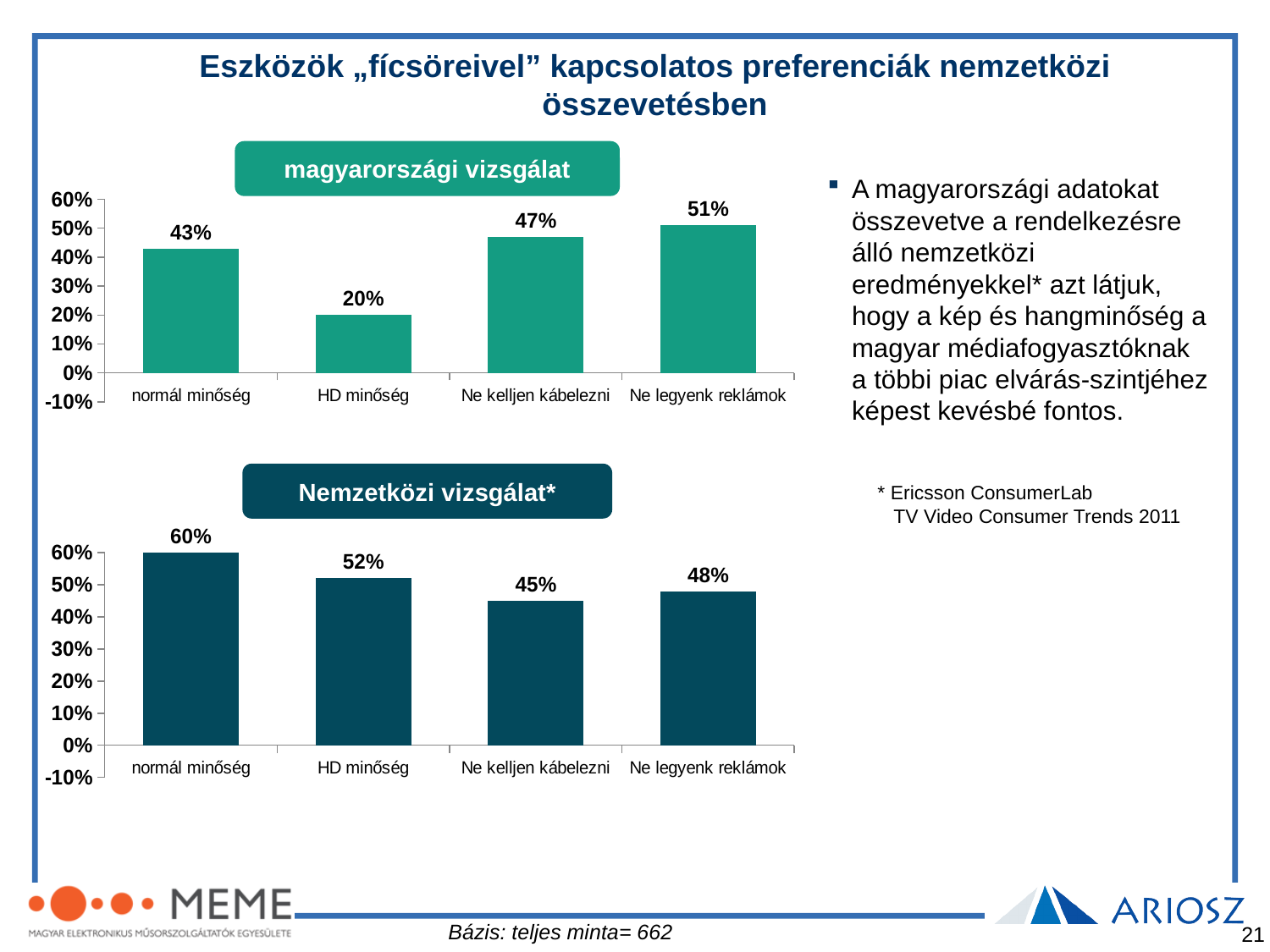
In the "magyarországi vizsgálat" chart, is the value for normál minőség greater or less than 40%? greater In the "Nemzetközi vizsgálat*" chart, do the values rise or fall from normál minőség to Ne kelljen kábelezni? fall What kind of chart is the "magyarországi vizsgálat" chart? bar chart What is the title of the lower chart on the slide? Nemzetközi vizsgálat* In the "Nemzetközi vizsgálat*" chart, which category has the lowest value? Ne kelljen kábelezni How many categories are shown in the "Nemzetközi vizsgálat*" chart? 4 In the "Nemzetközi vizsgálat*" chart, which is larger: the value for HD minőség or the value for Ne legyenk reklámok? HD minőség In the "Nemzetközi vizsgálat*" chart, what is the value for normál minőség? 60% In the "magyarországi vizsgálat" chart, what is the value for HD minőség? 20% In the "magyarországi vizsgálat" chart, what is the value for Ne kelljen kábelezni? 47% In the "magyarországi vizsgálat" chart, which category has the highest value? Ne legyenk reklámok In the "magyarországi vizsgálat" chart, what is the difference between the values for Ne legyenk reklámok and HD minőség? 31%